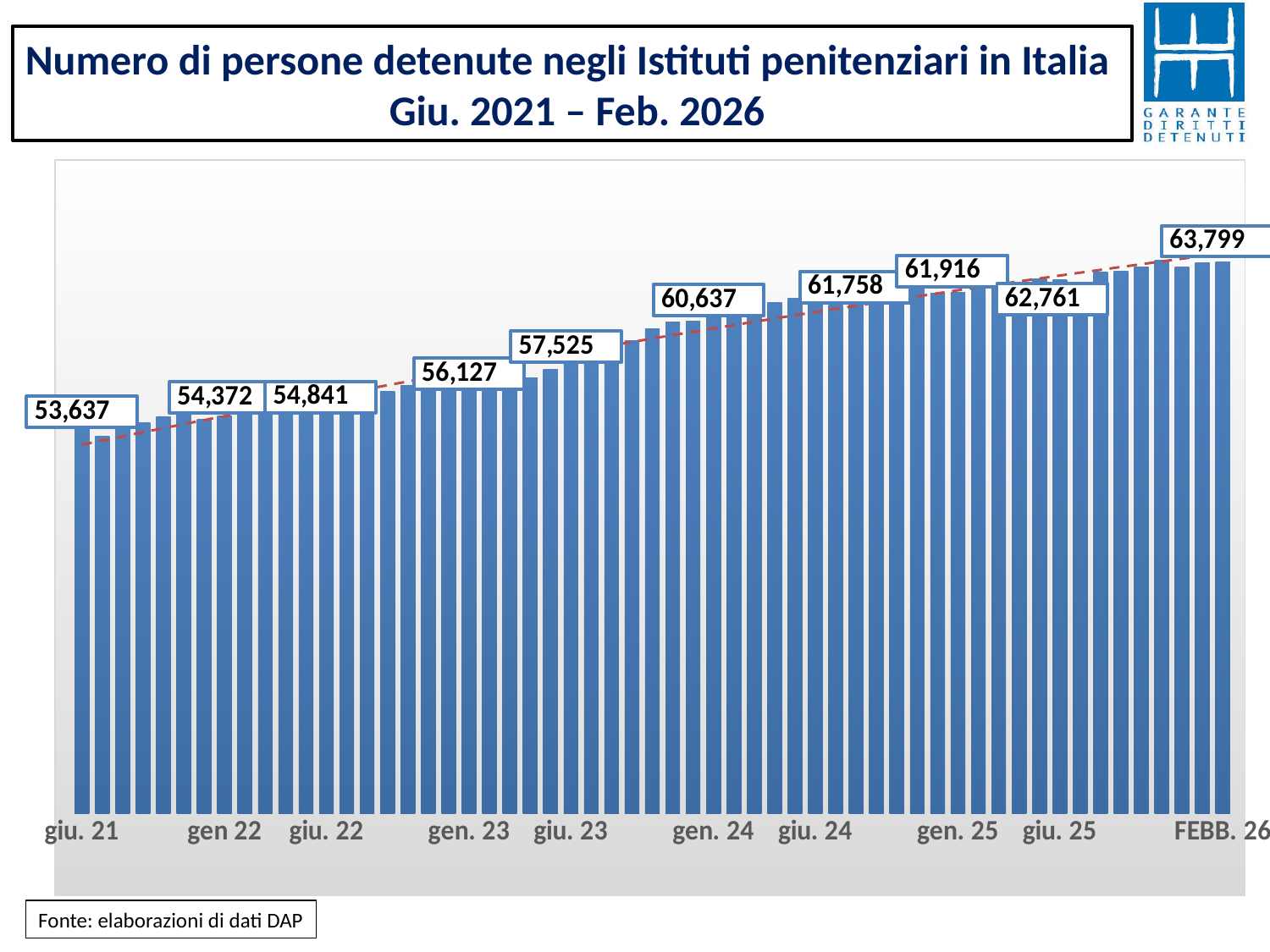
Which labelled period has the lowest value? giu. 21 What value is labelled for gen. 24? 60,637 What value is labelled for gen. 23? 56,127 What is the difference between the values for gen. 24 and giu. 23? 3,112 Which labelled period has the highest value? FEBB. 26 What value is labelled for FEBB. 26? 63,799 What is the difference between the values for FEBB. 26 and giu. 21? 10,162 Which is larger, the value for gen. 25 or the value for giu. 24? gen. 25 What is the number of detained persons shown for giu. 21? 53,637 What kind of chart is shown on the slide? Bar chart Do the values rise or fall from giu. 21 to FEBB. 26? Rise What value is labelled for giu. 25? 62,761